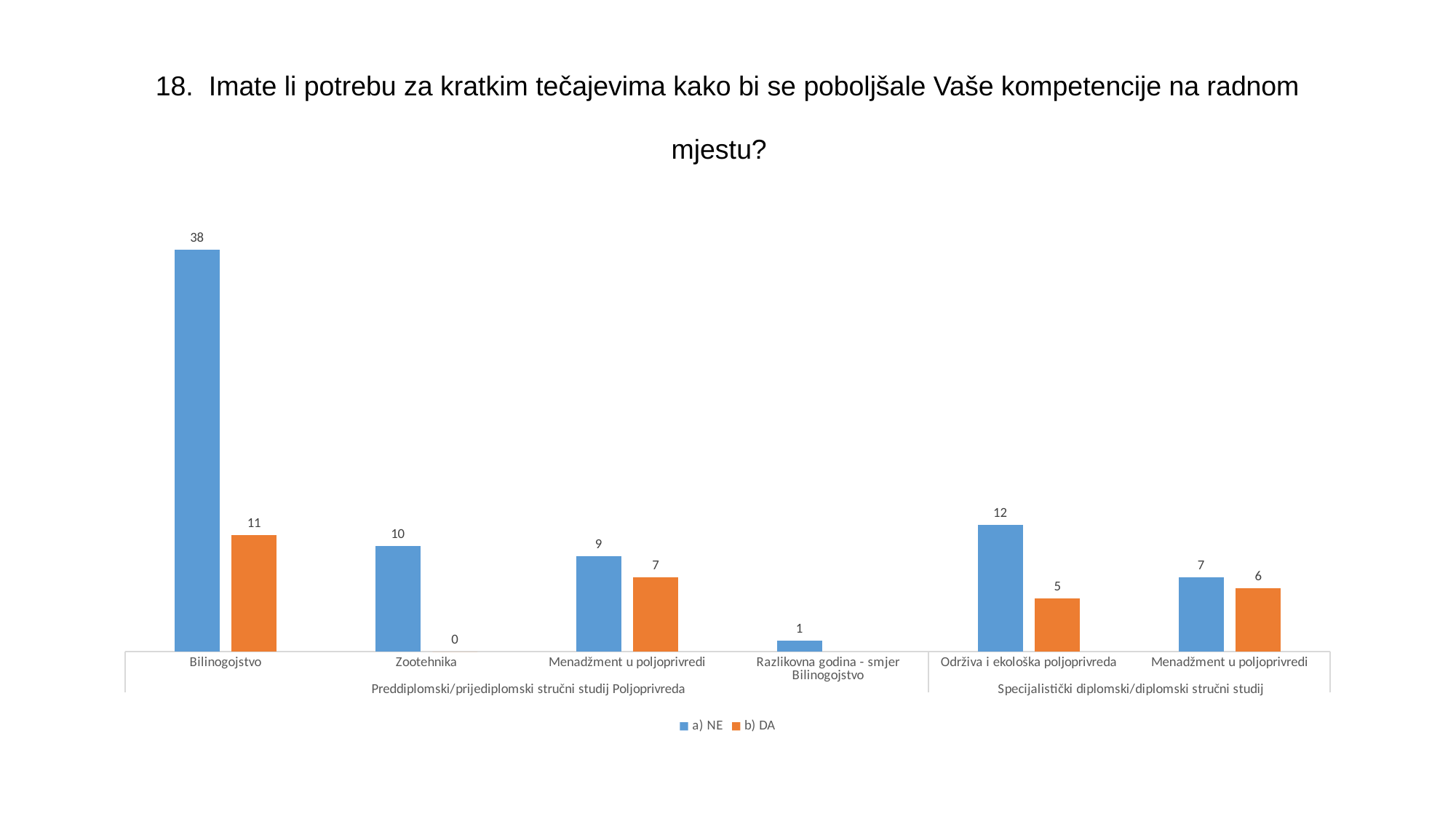
What is the value of a) NE for Bilinogojstvo? 38 What is the value of b) DA for Bilinogojstvo? 11 Which category has the lowest a) NE value? Razlikovna godina - smjer Bilinogojstvo What is the value of b) DA for Menadžment u poljoprivredi in the Specijalistički diplomski/diplomski stručni studij group? 6 What are the two series named in the legend? a) NE and b) DA What is the value of b) DA for Zootehnika? 0 What is the difference between the a) NE and b) DA values for Bilinogojstvo? 27 What is the value of a) NE for Održiva i ekološka poljoprivreda? 12 How many series does the legend list? 2 Which is larger for Menadžment u poljoprivredi in the Preddiplomski/prijediplomski stručni studij Poljoprivreda group: a) NE or b) DA? a) NE Which category has the highest a) NE value? Bilinogojstvo What type of chart is shown on the slide? bar chart